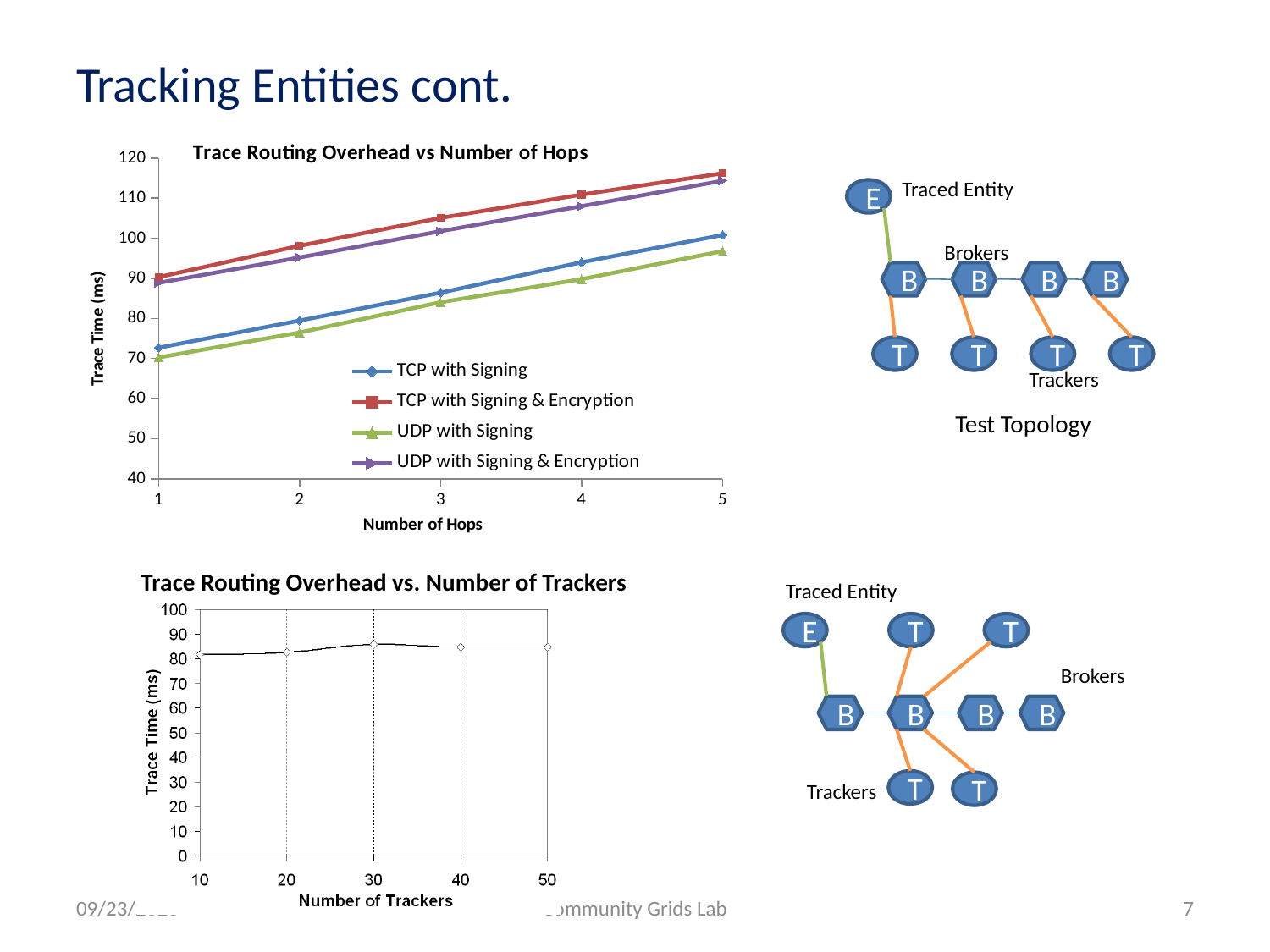
In the 'Trace Routing Overhead vs Number of Hops' chart, how many series does the legend list? 4 In the 'Trace Routing Overhead vs Number of Hops' chart, is the trace time for TCP with Signing & Encryption at 5 hops greater or less than 110? greater In the 'Trace Routing Overhead vs Number of Hops' chart, which is larger at 3 hops: TCP with Signing or UDP with Signing & Encryption? UDP with Signing & Encryption In the 'Trace Routing Overhead vs Number of Hops' chart, which series has the lowest trace time at 1 hop? UDP with Signing In the 'Trace Routing Overhead vs. Number of Trackers' chart, is the trace time at 30 trackers greater or less than 80? greater In the 'Trace Routing Overhead vs Number of Hops' chart, what is the label of the y axis? Trace Time (ms) In the 'Trace Routing Overhead vs. Number of Trackers' chart, how many data points are plotted? 5 In the 'Trace Routing Overhead vs Number of Hops' chart, which series has the highest trace time at 5 hops? TCP with Signing & Encryption In the 'Trace Routing Overhead vs Number of Hops' chart, how many hop values are plotted along the x axis? 5 In the 'Trace Routing Overhead vs Number of Hops' chart, what kind of chart is shown? line chart In the 'Trace Routing Overhead vs Number of Hops' chart, do trace times rise or fall as the number of hops increases? rise In the 'Trace Routing Overhead vs Number of Hops' chart, is the trace time for UDP with Signing at 1 hop greater or less than 80? less